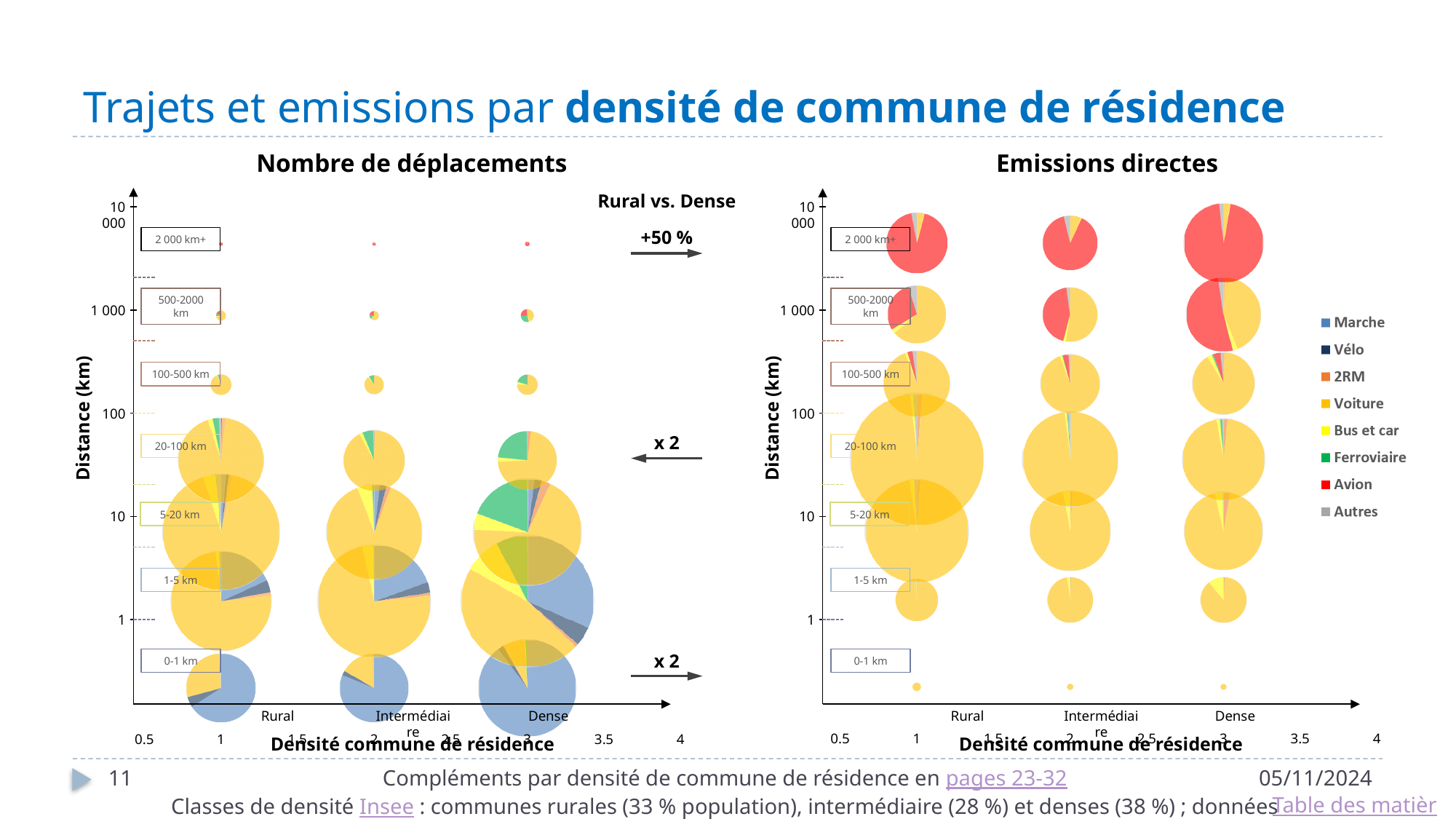
In the Emissions directes chart, for Rural, is the 20-100 km bubble larger or smaller than the 1-5 km bubble? larger Which legend entry in the Emissions directes chart is shown in red? Avion How many series does the legend of the Emissions directes chart list? 8 How many density categories are shown along the x axis of the Nombre de déplacements chart? 3 In the Nombre de déplacements chart, which distance band has the smallest bubble for Rural? 2 000 km+ What is the title of the left chart? Nombre de déplacements How many distance bands are labelled along the y axis of the Emissions directes chart? 7 In the Nombre de déplacements chart, for Dense, is the 0-1 km bubble larger or smaller than the 100-500 km bubble? larger What kind of chart is the Emissions directes chart? bubble chart In the Emissions directes chart, which distance band has the smallest bubble for Rural? 0-1 km In the Emissions directes chart, which distance band has the largest bubble for Rural? 20-100 km